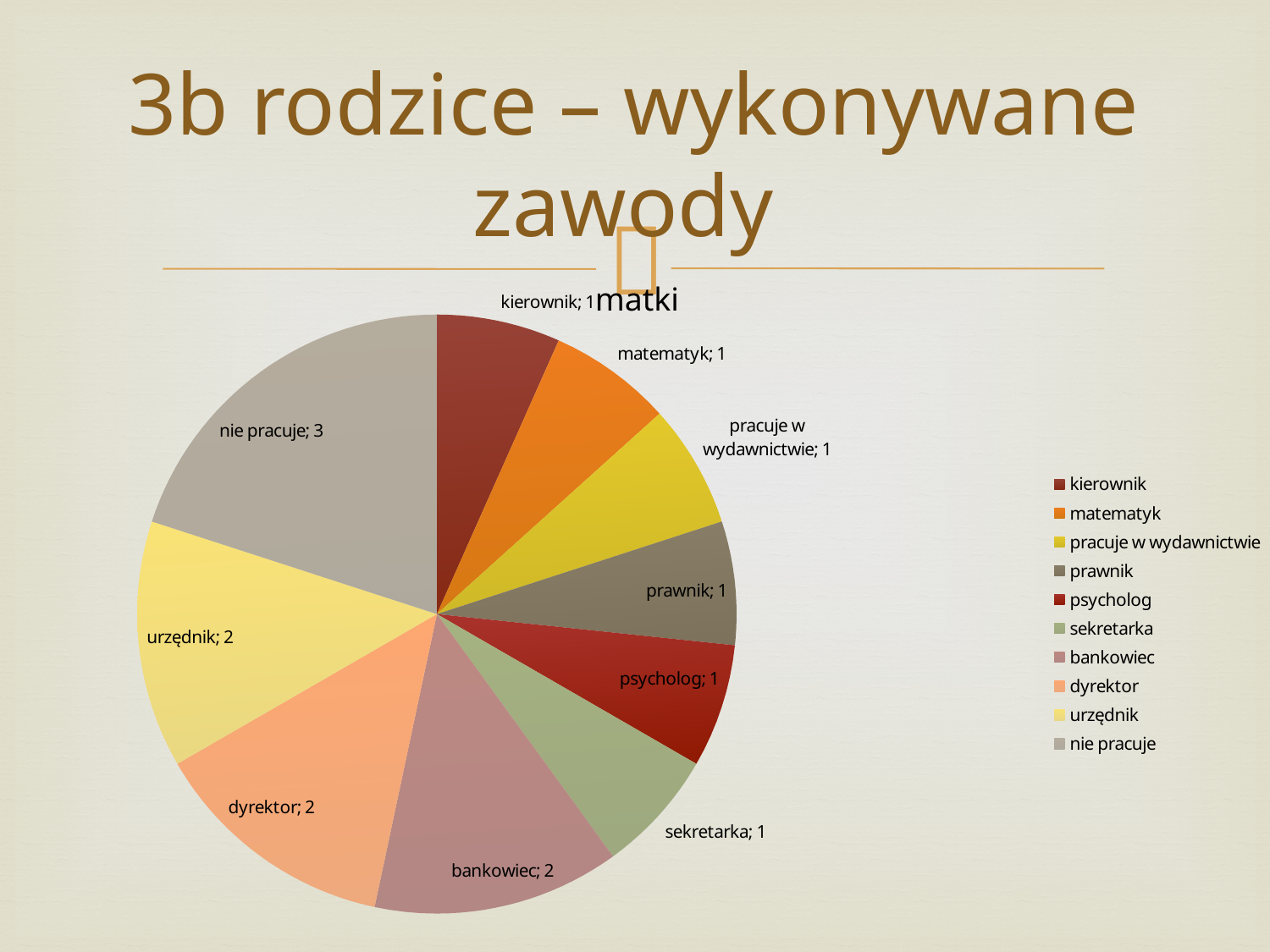
What is the difference between the values for 'nie pracuje' and 'dyrektor'? 1 What is the value for 'psycholog'? 1 How many entries does the legend list? 10 What is the value for 'nie pracuje'? 3 What kind of chart is shown on the slide? pie chart What is the total of all the values in the pie chart? 15 Which is larger, the value for 'urzędnik' or the value for 'prawnik'? urzędnik What is the value for 'bankowiec'? 2 How many categories does the pie chart have? 10 What share of the pie does 'nie pracuje' represent? 20% What is the title of the pie chart? matki Which category has the largest slice of the pie? nie pracuje